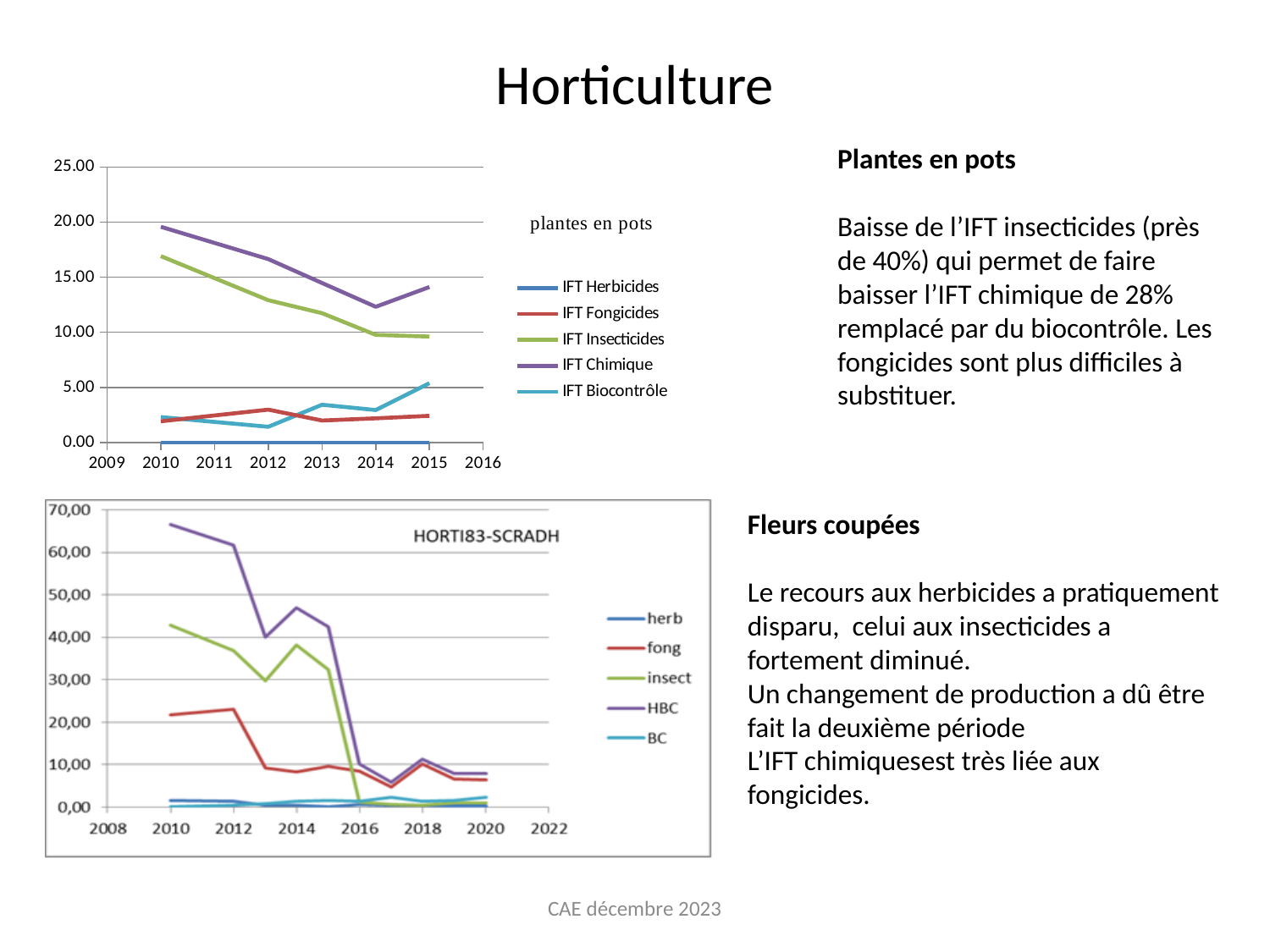
In the bottom chart ("HORTI83-SCRADH"), which series has the highest value in 2010? HBC In the bottom chart ("HORTI83-SCRADH"), does the insect series rise or fall from 2010 to 2020? fall In the top chart ("plantes en pots"), is the value of IFT Chimique in 2010 greater or less than 15.00? greater How many series does the legend of the top chart ("plantes en pots") list? 5 In the top chart ("plantes en pots"), which series has the lowest values across all years? IFT Herbicides In the bottom chart ("HORTI83-SCRADH"), is the value of HBC in 2010 greater or less than 60,00? greater In the top chart ("plantes en pots"), does IFT Insecticides rise or fall from 2010 to 2015? fall What kind of chart is the top chart titled "plantes en pots"? line chart In the bottom chart ("HORTI83-SCRADH"), which is larger in 2010: fong or insect? insect In the top chart ("plantes en pots"), which series has the highest value in 2010? IFT Chimique In the top chart ("plantes en pots"), which is larger in 2015: IFT Biocontrôle or IFT Fongicides? IFT Biocontrôle How many series does the legend of the bottom chart ("HORTI83-SCRADH") list? 5